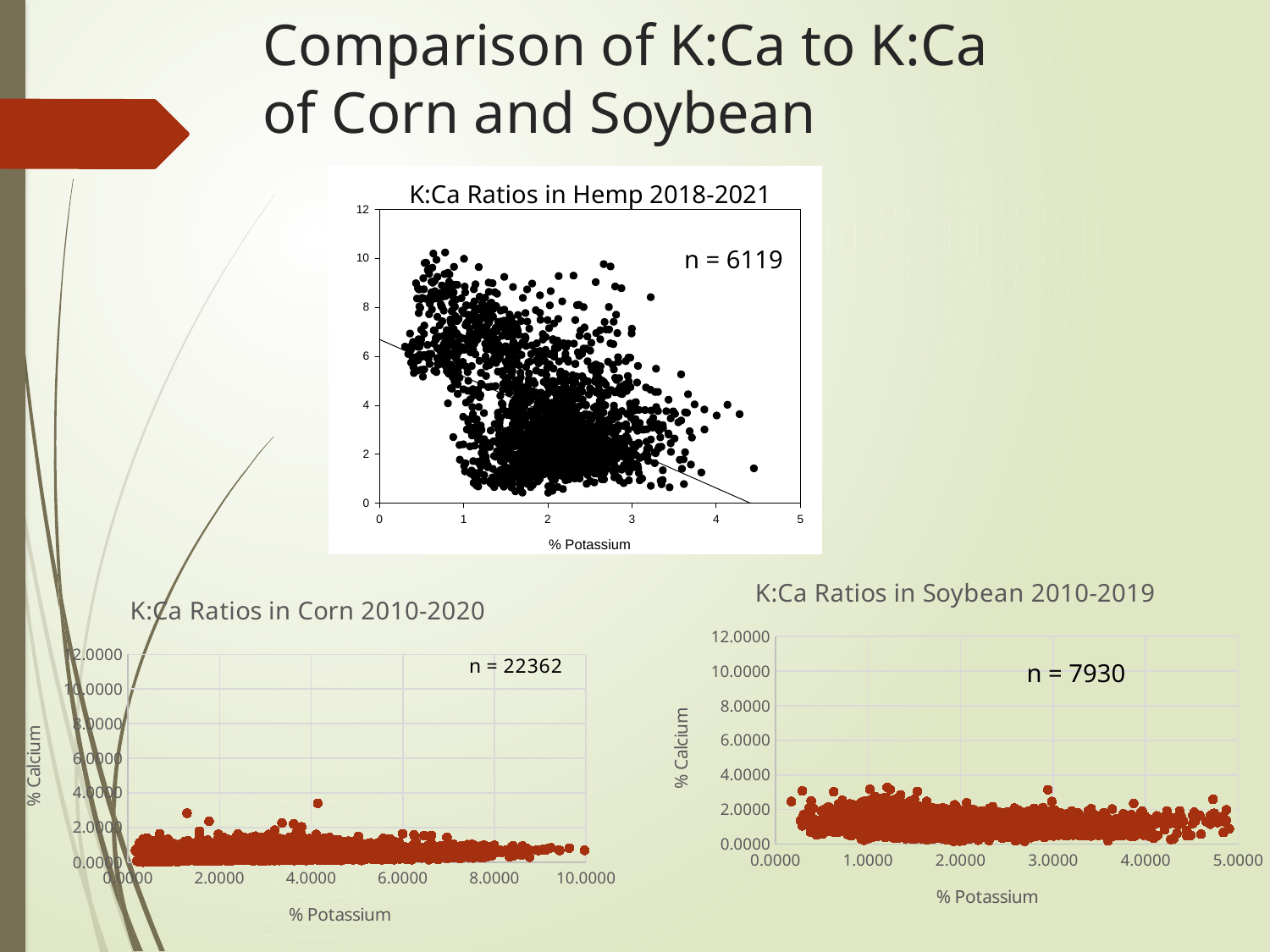
What is the difference between the n value in the Corn chart and the n value in the Soybean chart? 14432 In the 'K:Ca Ratios in Hemp 2018-2021' chart, what is the value of n? n = 6119 What kind of chart is the 'K:Ca Ratios in Hemp 2018-2021' chart? scatter chart What is the y-axis label on the 'K:Ca Ratios in Corn 2010-2020' chart? % Calcium Which chart has the largest sample size n: Hemp, Corn or Soybean? Corn In the 'K:Ca Ratios in Hemp 2018-2021' chart, does the fitted trend line rise or fall as % Potassium increases? fall Which has a larger n, the Soybean chart or the Hemp chart? Soybean In the 'K:Ca Ratios in Soybean 2010-2019' chart, what is the value of n? n = 7930 What is the x-axis label on the 'K:Ca Ratios in Soybean 2010-2019' chart? % Potassium Which chart has the smallest sample size n: Hemp, Corn or Soybean? Hemp How many charts are shown on the slide? 3 In the 'K:Ca Ratios in Corn 2010-2020' chart, what is the value of n? n = 22362